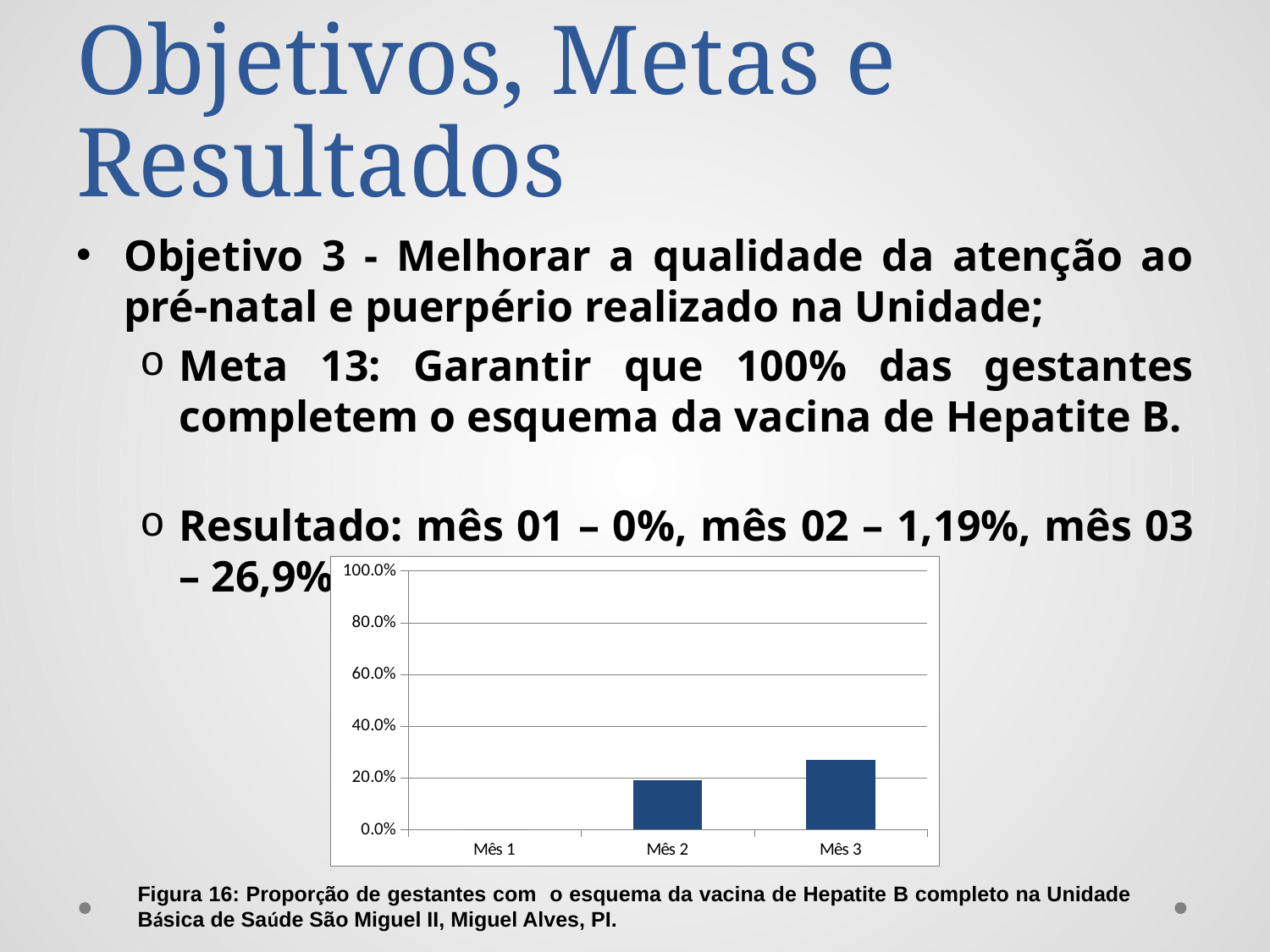
Is the value for Mês 2 greater or less than 40.0%? less Do the values in the chart rise or fall from Mês 1 to Mês 3? rise Is the value for Mês 3 greater or less than 40.0%? less What is the value shown for Mês 1 in the chart? 0.0% Which month has the highest bar in the chart? Mês 3 What is the figure number given in the caption below the chart? Figura 16 Which is larger in the chart, the value for Mês 2 or the value for Mês 3? Mês 3 What kind of chart is shown on the slide? bar chart What is the highest tick label on the y axis of the chart? 100.0% How many categories are shown on the x axis of the chart? 3 Is the value for Mês 3 greater or less than 20.0%? greater Which month has the lowest value in the chart? Mês 1